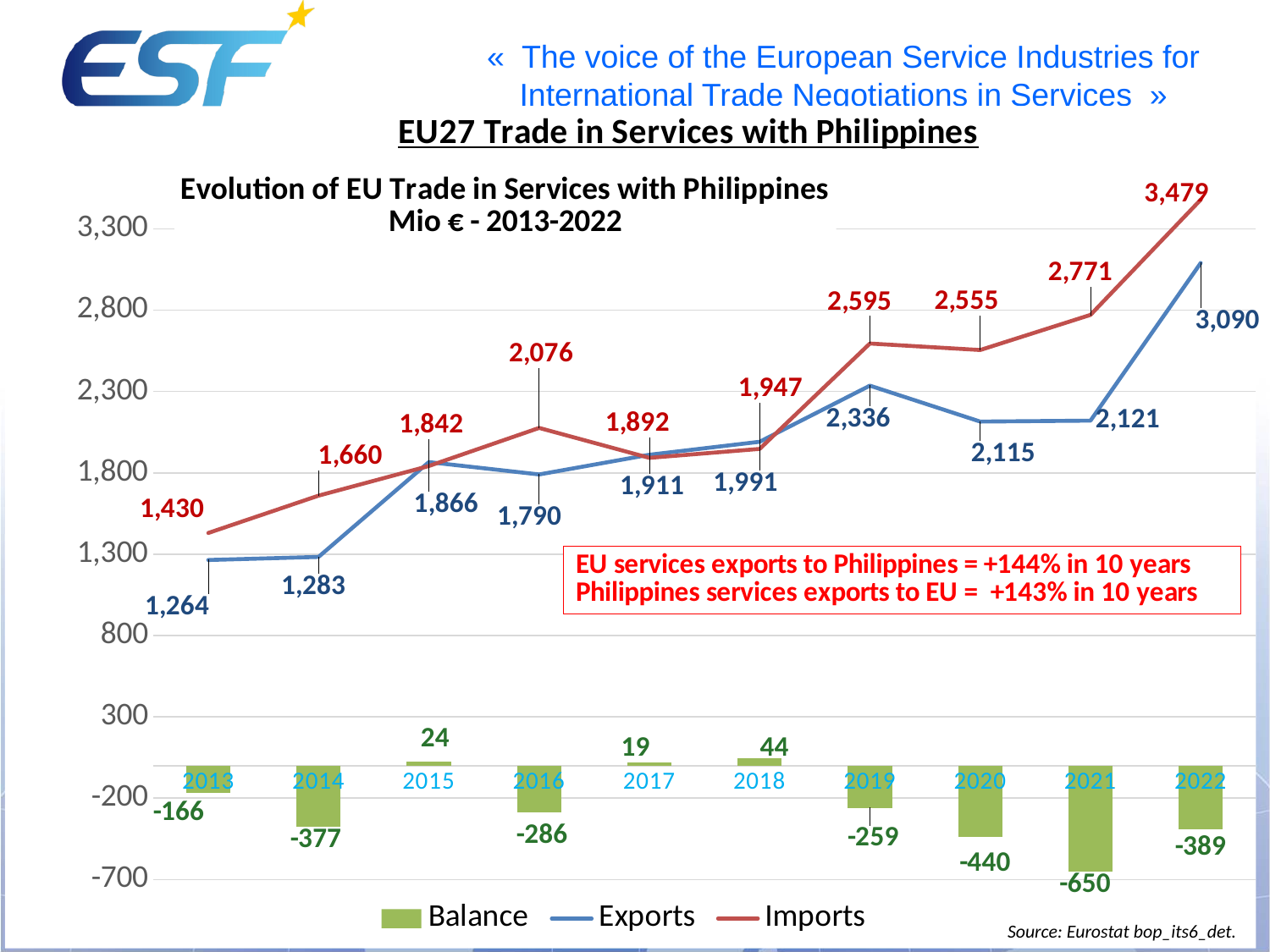
In which year is the Balance lowest? 2021 How many series does the legend list? 3 What is the difference between Imports and Exports in 2022? 389 What is the Balance value for 2021? -650 In which year are Exports lowest? 2013 In which year are Imports highest? 2022 Do Imports rise or fall from 2013 to 2016? rise What is the value of Exports in 2022? 3,090 How many years are shown on the x axis? 10 In 2015, which is larger, Exports or Imports? Exports What is the value of Imports in 2016? 2,076 Is the value for Imports in 2013 greater or less than 1,300? greater